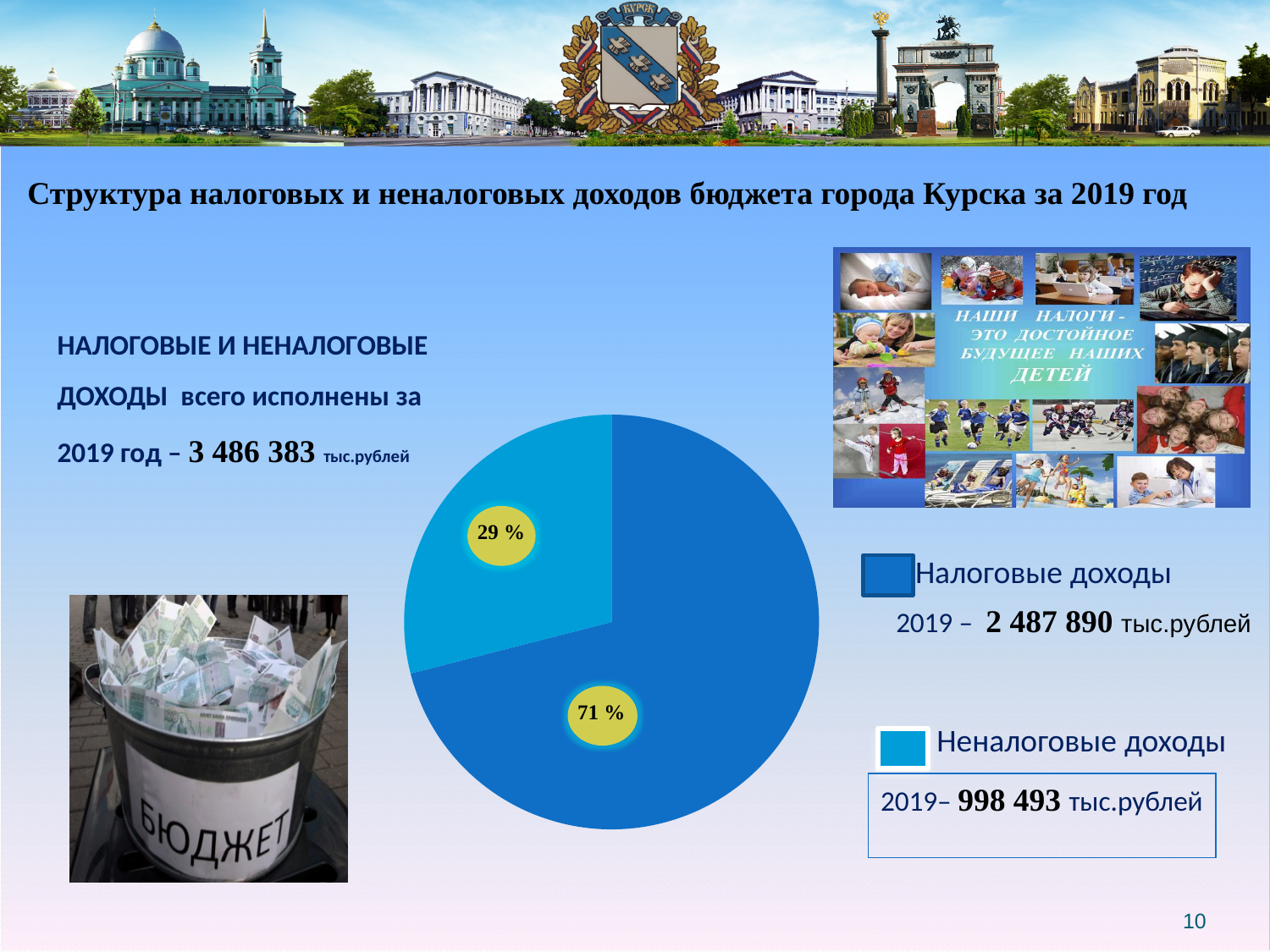
What is the total of tax and non-tax revenues for 2019 stated on the slide? 3 486 383 тыс.рублей Which is larger: the slice for Налоговые доходы or the slice for Неналоговые доходы? Налоговые доходы What is the value of Неналоговые доходы for 2019 shown next to the pie chart? 998 493 тыс.рублей What colour is the slice representing Неналоговые доходы? light blue Which category has the largest slice in the pie chart? Налоговые доходы What kind of chart is shown on the slide? pie chart What share of the pie does the slice for Неналоговые доходы (non-tax revenues) take? 29 % By how many percentage points does the Налоговые доходы slice exceed the Неналоговые доходы slice? 42 % What is the value of Налоговые доходы for 2019 shown next to the pie chart? 2 487 890 тыс.рублей Which category has the smallest slice in the pie chart? Неналоговые доходы How many slices does the pie chart have? 2 What share of the pie does the slice for Налоговые доходы (tax revenues) take? 71 %